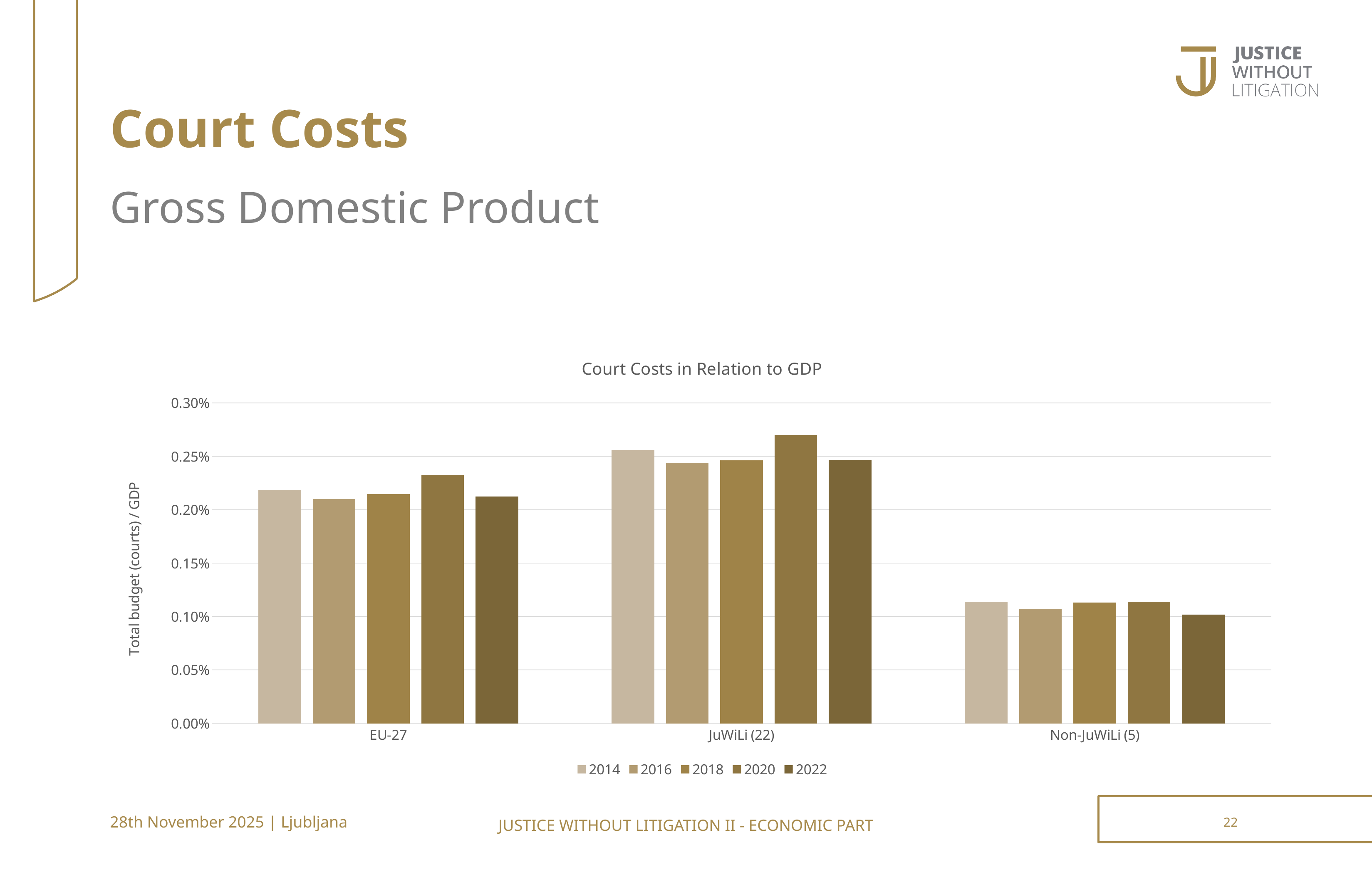
Is the 2020 value for EU-27 greater or less than 0.25%? less Is the 2020 value for JuWiLi (22) greater or less than 0.25%? greater Which year has the highest value for JuWiLi (22)? 2020 Which country group has the lowest values overall? Non-JuWiLi (5) What kind of chart is shown on the slide? bar chart Which is larger, the 2014 value for EU-27 or the 2014 value for JuWiLi (22)? JuWiLi (22) What is the label of the vertical axis? Total budget (courts) / GDP Is the 2016 value for EU-27 greater or less than 0.20%? greater How many country groups (categories) are shown on the x axis? 3 How many years (series) does the legend list? 5 What is the title of the chart? Court Costs in Relation to GDP